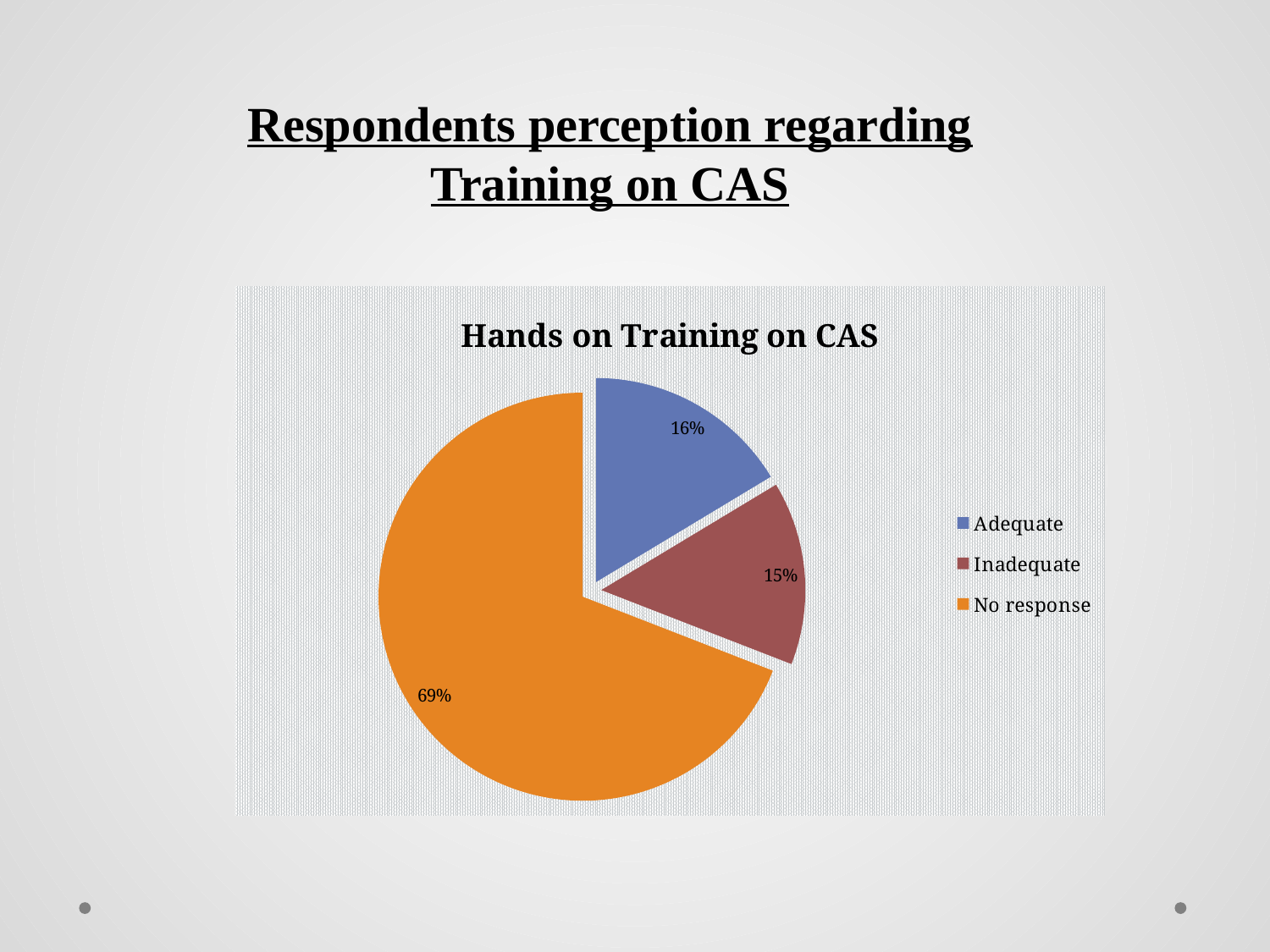
What is the difference in percentage points between Adequate and Inadequate? 1 What type of chart is shown on the slide? pie chart How many categories does the legend list? 3 Which category has the smallest slice of the pie? Inadequate What percentage of respondents rated the training as Adequate? 16% What percentage of respondents rated the training as Inadequate? 15% What colour is the No response slice? orange Which is larger, the No response slice or the Inadequate slice? No response What is the difference in percentage points between No response and Adequate? 53 Which category has the largest slice of the pie? No response What is the title of the chart? Hands on Training on CAS What share of the pie is No response? 69%